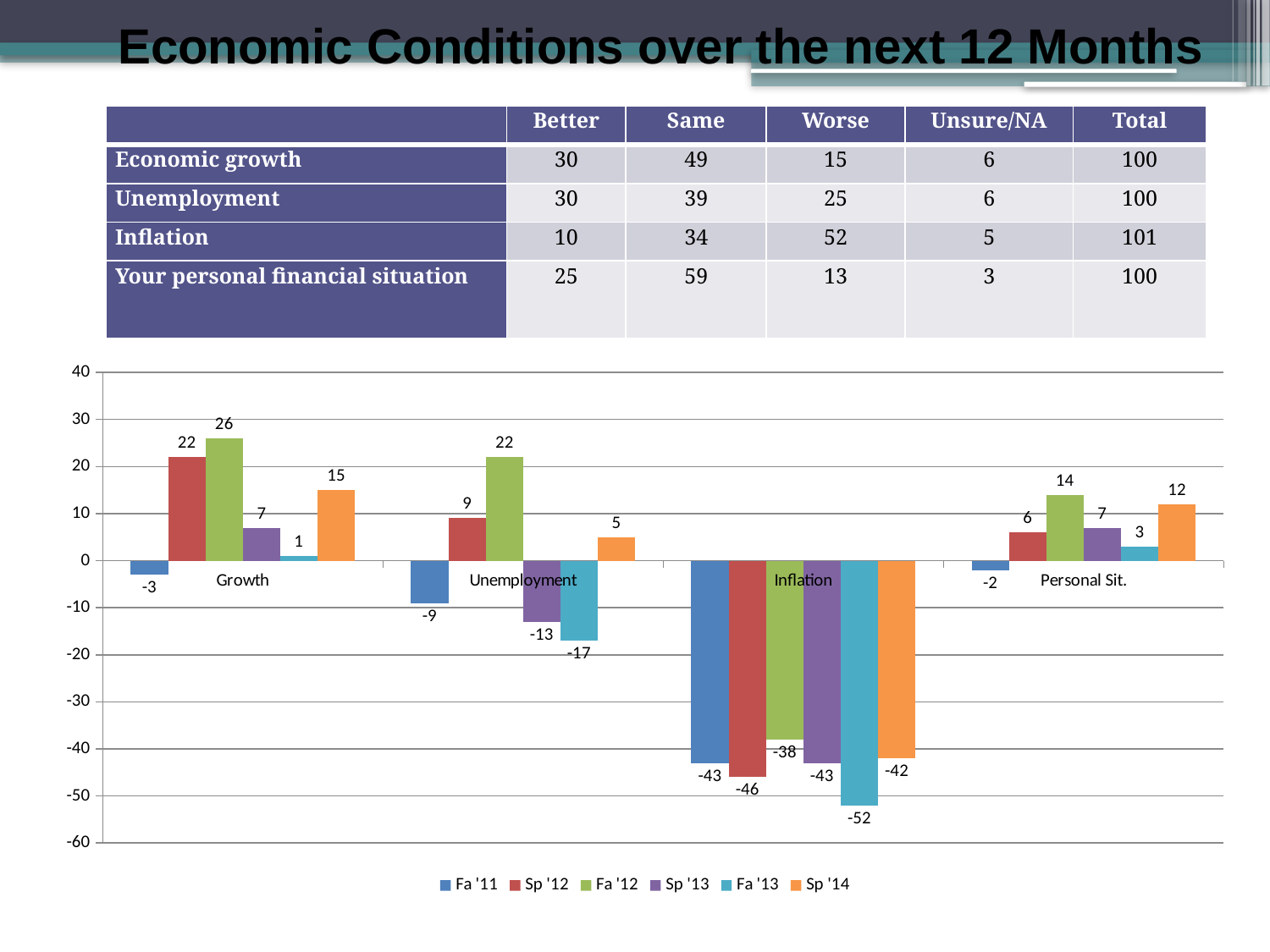
How many categories are shown on the x axis of the chart? 4 What kind of chart is shown on the slide? bar chart What is the value for Fa '13 in the Inflation category? -52 How many series does the chart legend list? 6 Which series has the lowest value in the Unemployment category? Fa '13 What is the value for Sp '14 in the Personal Sit. category? 12 What is the value for Fa '12 in the Growth category? 26 What is the difference between the Sp '12 and Fa '12 values in the Inflation category? 8 Is the value for Sp '12 in the Inflation category greater or less than -40? less Which series is shown in orange in the chart legend? Sp '14 Which is larger in the Growth category, the Sp '13 value or the Sp '14 value? Sp '14 Which series has the highest value in the Personal Sit. category? Fa '12